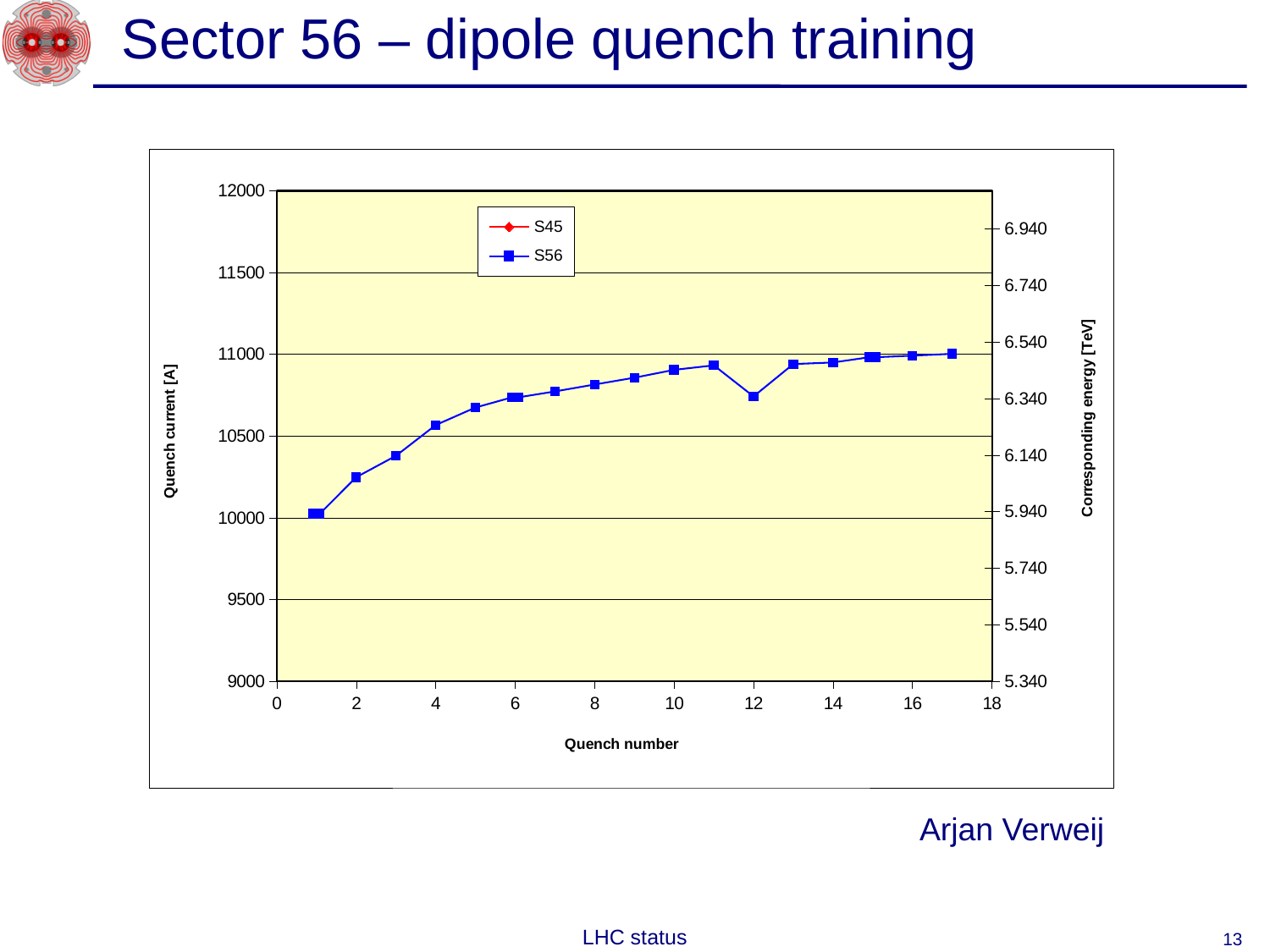
Which has the larger S56 quench current, quench number 11 or quench number 12? quench number 11 Is the S56 quench current at quench number 2 greater or less than 10000 A? greater At which quench number is the S56 quench current lowest? 1 Is the S56 quench current at quench number 3 greater or less than 10500 A? less Do the S56 quench current values generally rise or fall as the quench number increases? rise Which series are listed in the legend? S45 and S56 At which quench number is the S56 quench current highest? 17 Is the S56 quench current at quench number 12 greater or less than 11000 A? less How many series does the legend list? 2 What is the label of the x axis? Quench number What kind of chart is shown on the slide? line chart How many data points are plotted for the S56 series? 17